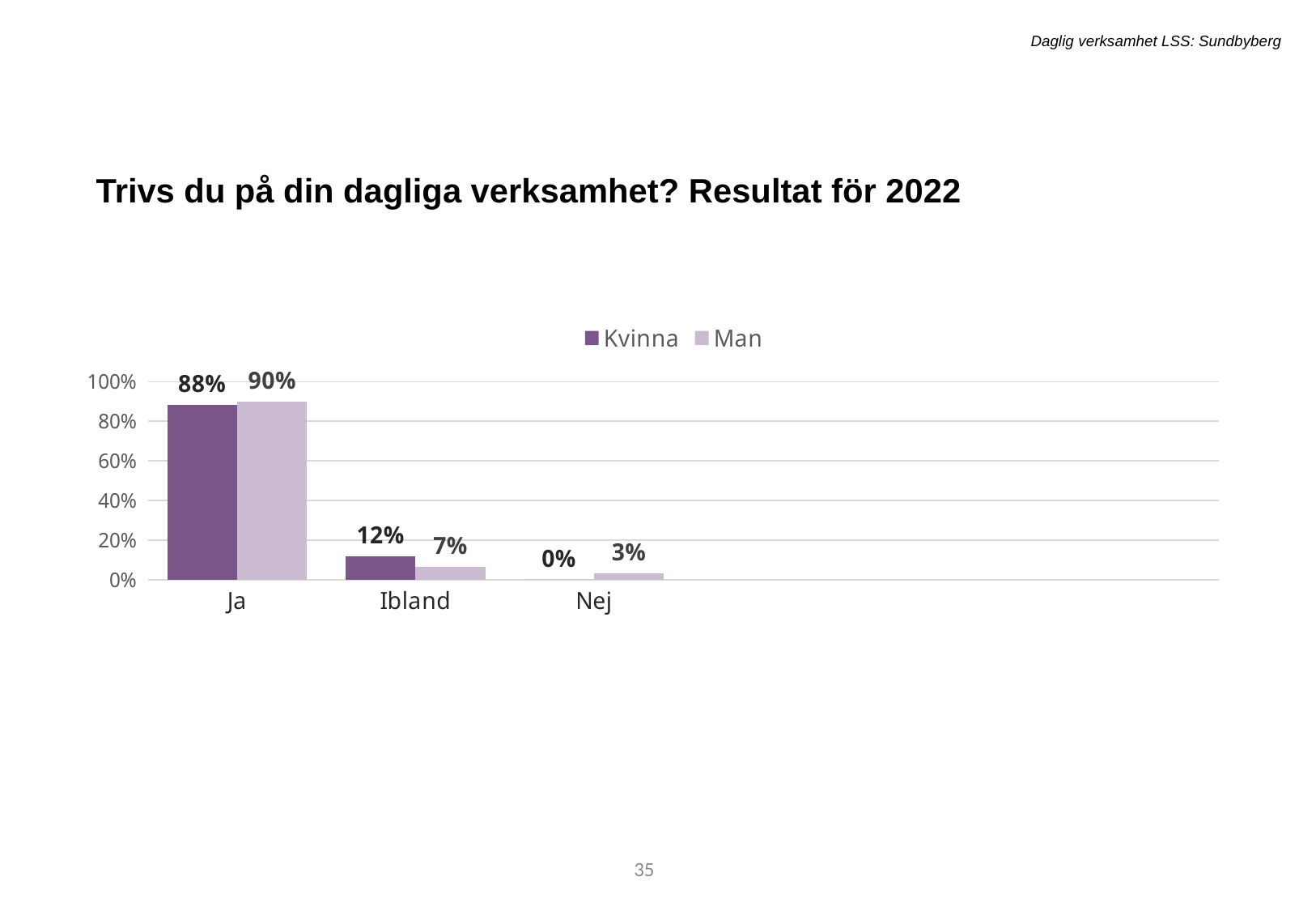
How many categories are shown on the x axis? 3 What is the value for Man in the Nej category? 3% What is the difference between the Kvinna and Man values in the Ibland category? 5% Which category has the highest value for Kvinna? Ja Which series is shown in the darker purple colour? Kvinna How many series does the legend list? 2 What is the value for Kvinna in the Ibland category? 12% In the Ja category, which series has the larger value, Kvinna or Man? Man What is the value for Kvinna in the Ja category? 88% Which category has the lowest value for Man? Nej What is the value for Man in the Ja category? 90% What kind of chart is shown on the slide? Bar chart